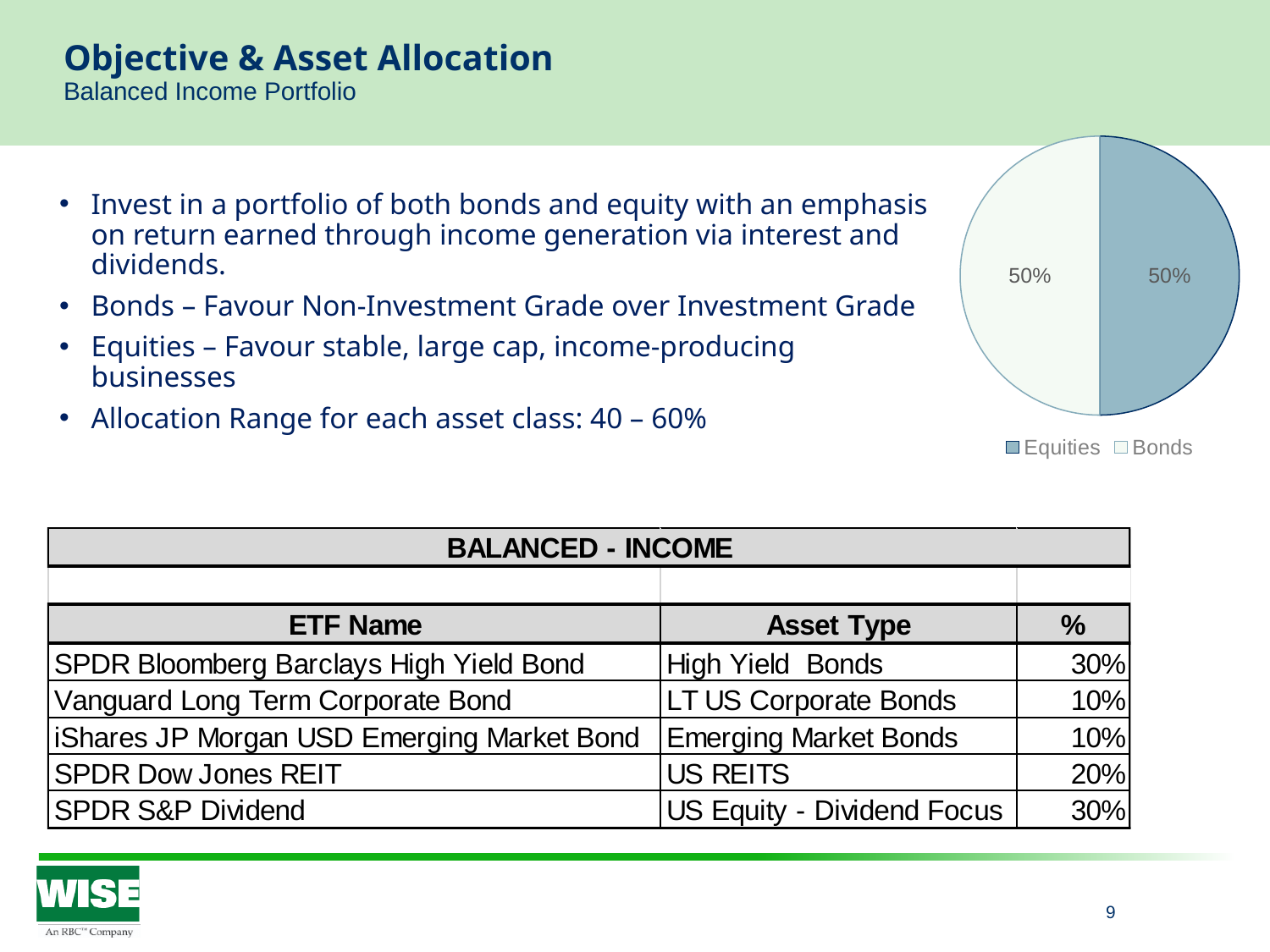
How many slices does the pie chart have? 2 What do the two slices of the pie chart add up to? 100% In the pie chart, which is larger, Equities or Bonds, or are they equal? They are equal What is the difference between the Equities and Bonds percentages in the pie chart? 0% In the pie chart, what percentage is shown for Bonds? 50% What share of the pie chart does Bonds represent? 50% How many entries does the pie chart's legend list? 2 What kind of chart is shown on the slide? Pie chart In the pie chart, which category is shown in the darker blue slice? Equities In the pie chart, what percentage is shown for Equities? 50% What are the two legend entries of the pie chart? Equities and Bonds